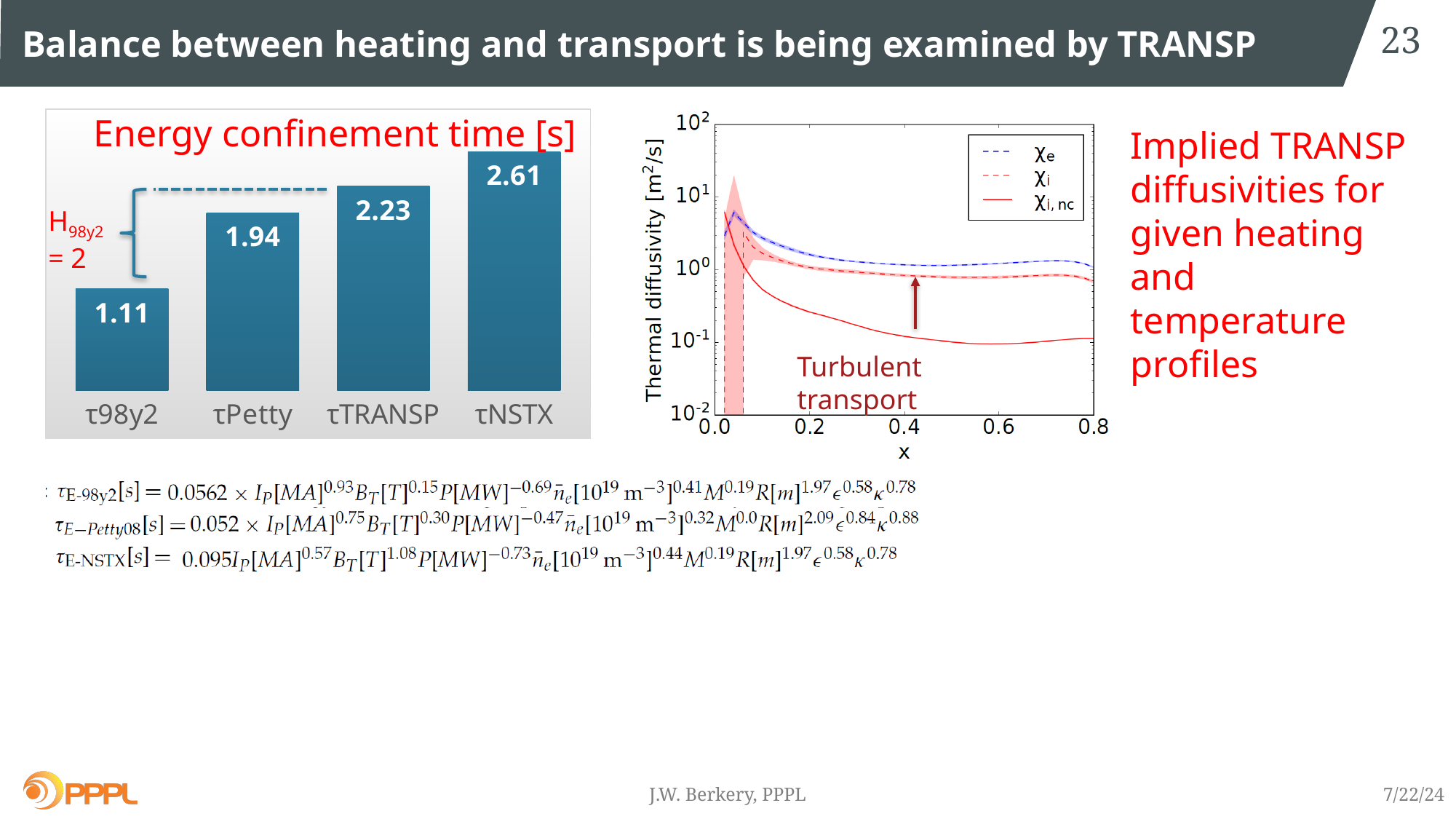
What is the x-axis label of the Thermal diffusivity chart? x How many bars are in the Energy confinement time chart? 4 In the Energy confinement time chart, do the values rise or fall from left to right? Rise In the Energy confinement time chart, which category has the highest value? τNSTX In the Energy confinement time chart, what is the value for τTRANSP? 2.23 In the Energy confinement time chart, what is the value for τPetty? 1.94 How many series does the legend of the Thermal diffusivity chart list? 3 In the Energy confinement time chart, which category has the lowest value? τ98y2 In the Energy confinement time chart, which is larger, τPetty or τTRANSP? τTRANSP In the Energy confinement time chart, what is the value for τ98y2? 1.11 What kind of chart is the Energy confinement time chart? Bar chart In the Energy confinement time chart, what is the difference between τNSTX and τ98y2? 1.50